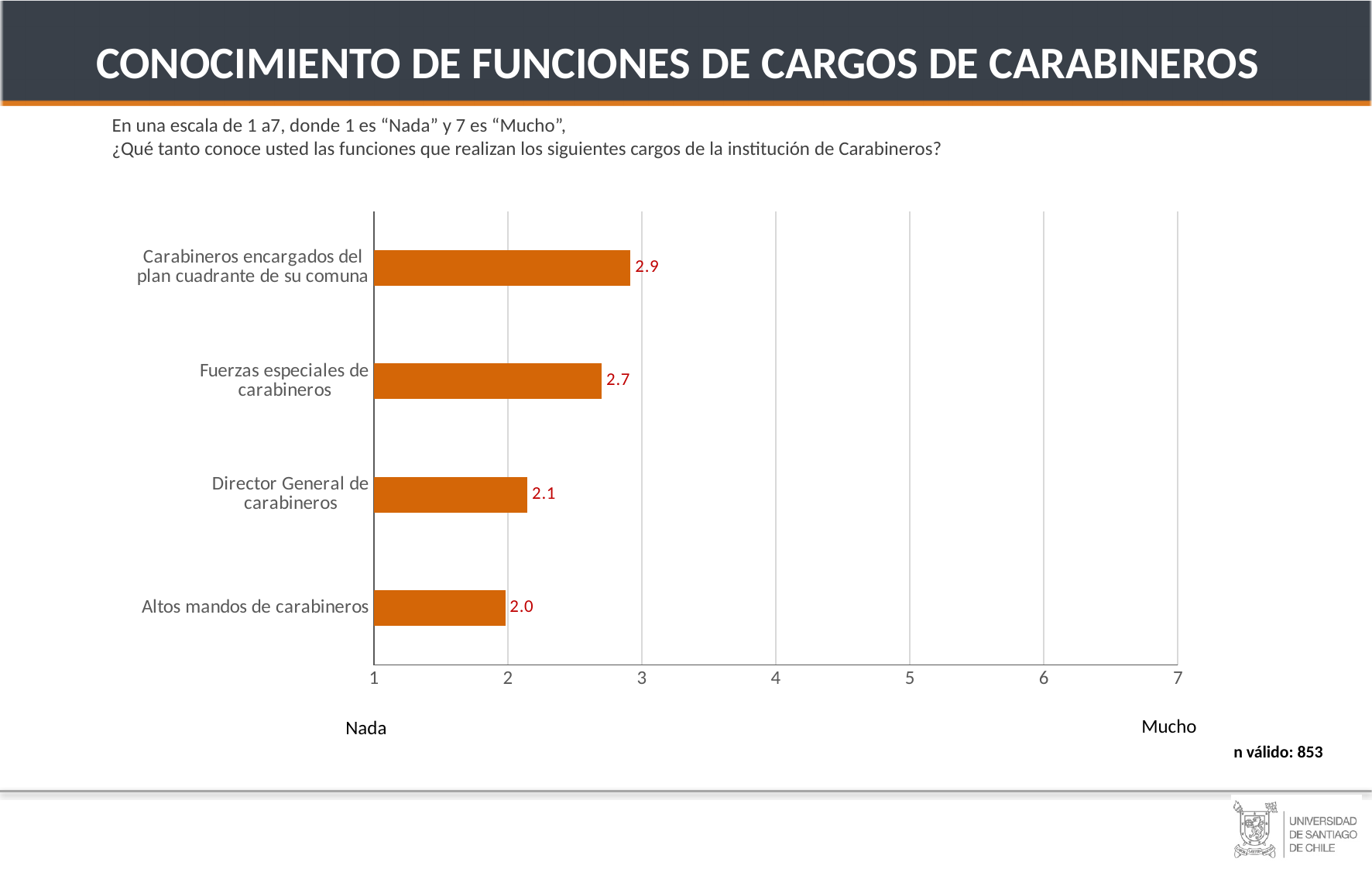
What kind of chart is shown on the slide? bar chart Is the value for "Carabineros encargados del plan cuadrante de su comuna" greater or less than 3? less What is the value for "Altos mandos de carabineros"? 2.0 How many categories are shown in the chart? 4 Which is larger: the value for "Fuerzas especiales de carabineros" or for "Director General de carabineros"? Fuerzas especiales de carabineros What is the difference between the values for "Carabineros encargados del plan cuadrante de su comuna" and "Altos mandos de carabineros"? 0.9 What is the value for "Director General de carabineros"? 2.1 What is the value for "Carabineros encargados del plan cuadrante de su comuna"? 2.9 What is the valid sample size (n válido) shown on the slide? 853 Which category has the highest value? Carabineros encargados del plan cuadrante de su comuna What is the value for "Fuerzas especiales de carabineros"? 2.7 Which category has the lowest value? Altos mandos de carabineros